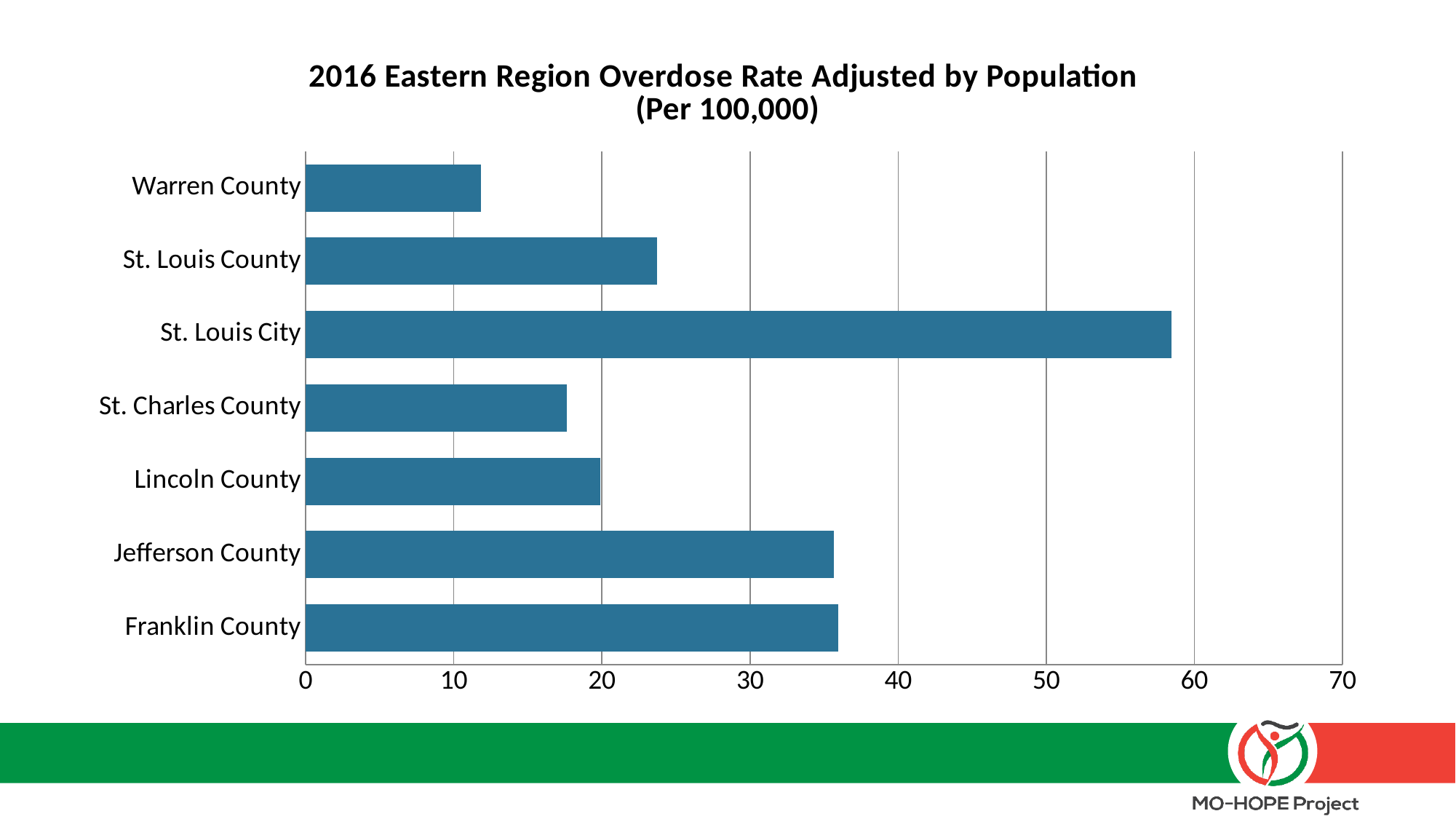
Is the value for Warren County greater or less than 20? less Which county or city has the highest overdose rate in the chart? St. Louis City Is the value for Jefferson County greater or less than 30? greater Which has a higher overdose rate, Franklin County or Lincoln County? Franklin County How many counties or cities are shown in the chart? 7 Is the value for St. Louis County greater or less than 20? greater What is the title of the chart? 2016 Eastern Region Overdose Rate Adjusted by Population (Per 100,000) What kind of chart is shown on the slide? bar chart Which has a higher overdose rate, St. Louis County or St. Louis City? St. Louis City Which county has the lowest overdose rate in the chart? Warren County